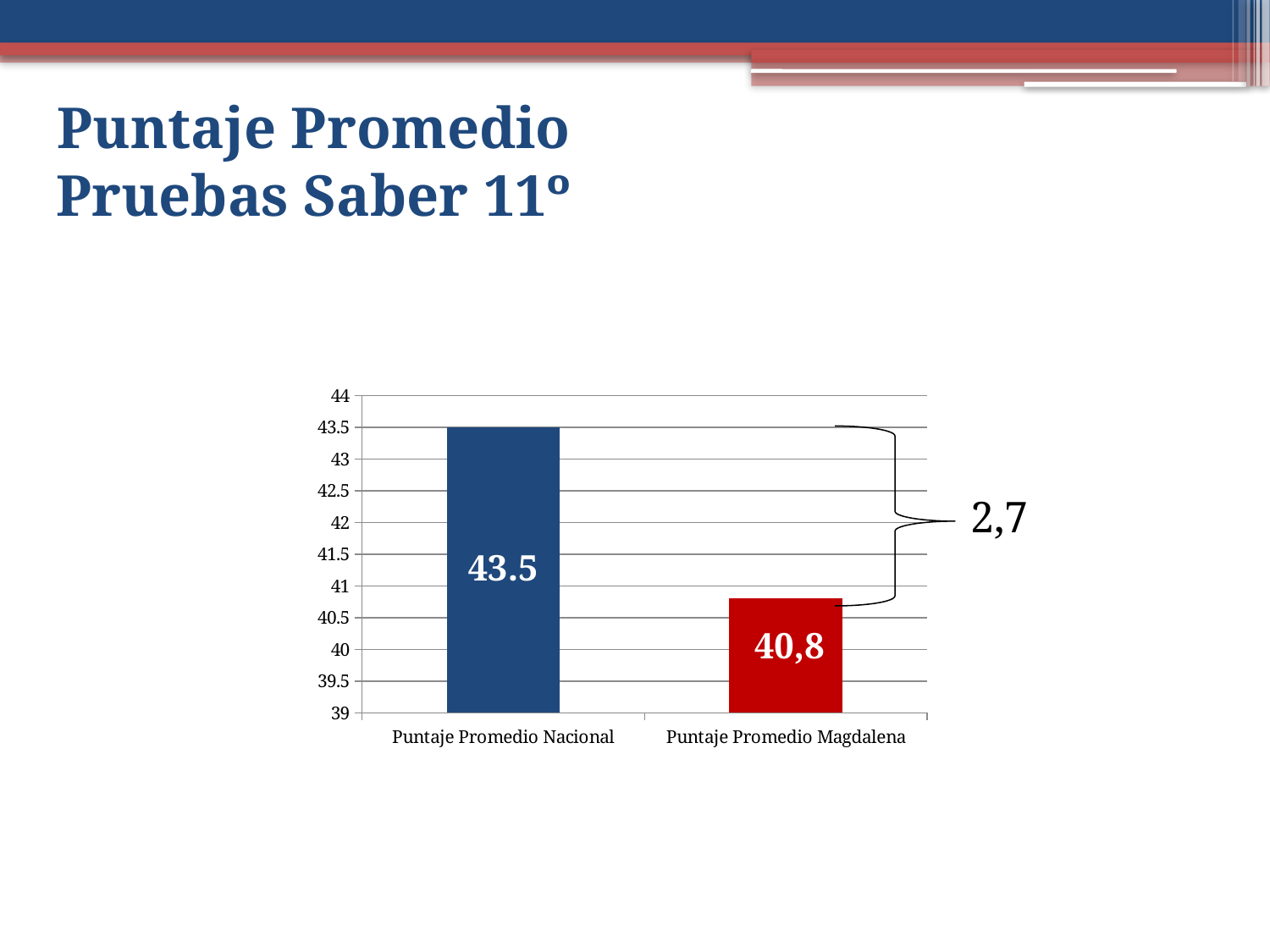
What colour is the bar for Puntaje Promedio Magdalena? red Which is larger, Puntaje Promedio Nacional or Puntaje Promedio Magdalena? Puntaje Promedio Nacional Which category has the lowest value? Puntaje Promedio Magdalena Is the value for Puntaje Promedio Magdalena greater or less than 41? less Which category has the highest value? Puntaje Promedio Nacional What is the title of the slide? Puntaje Promedio Pruebas Saber 11º What kind of chart is shown on the slide? bar chart Is the value for Puntaje Promedio Nacional greater or less than 43? greater How many categories are shown in the chart? 2 What is the value for Puntaje Promedio Magdalena? 40,8 What is the value for Puntaje Promedio Nacional? 43.5 What is the difference between Puntaje Promedio Nacional and Puntaje Promedio Magdalena? 2,7